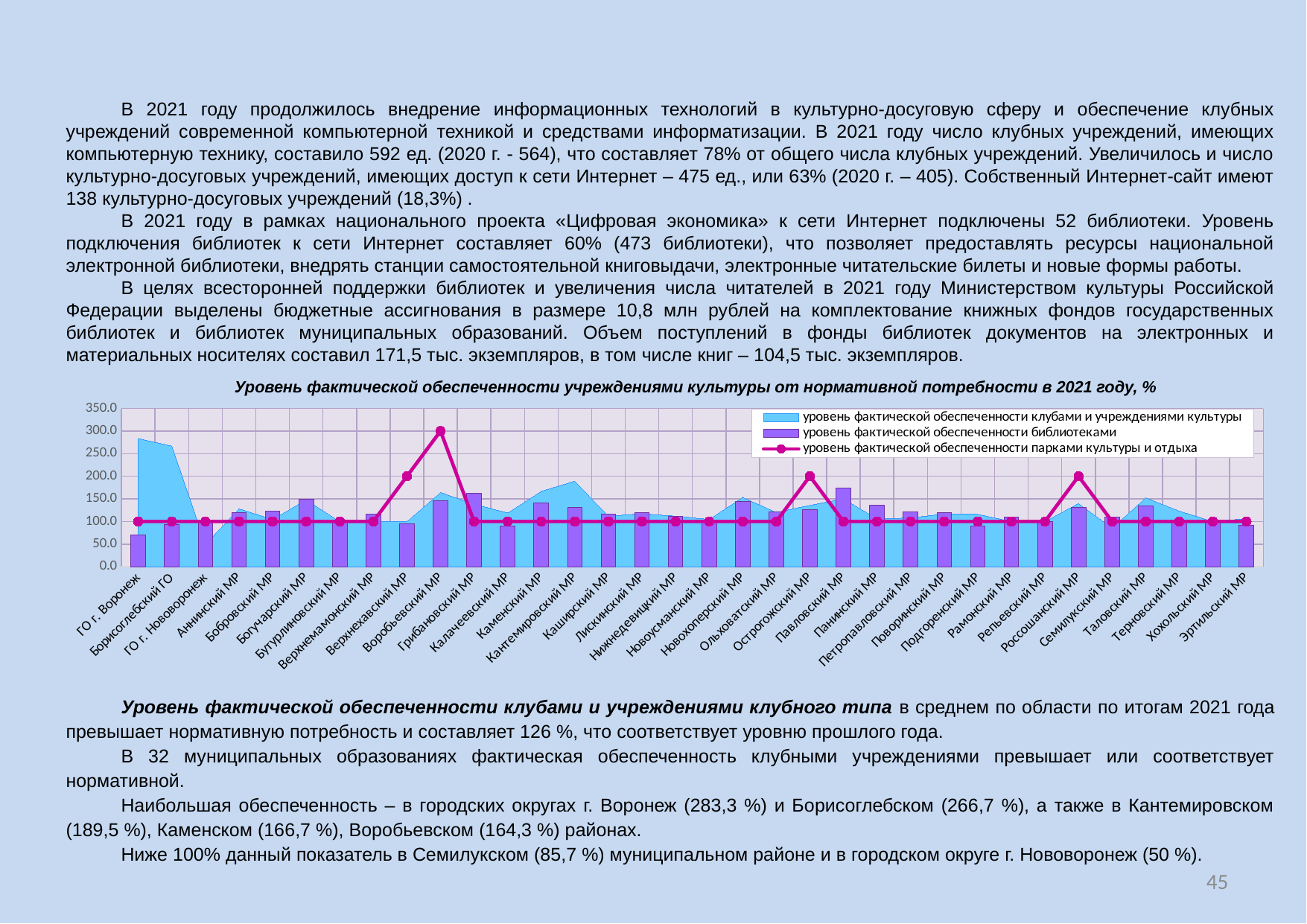
How many municipalities are shown along the x axis of the chart? 34 What is the title of the chart? Уровень фактической обеспеченности учреждениями культуры от нормативной потребности в 2021 году, % How many series does the chart legend list? 3 Is the level of provision with libraries in Павловский МР greater or less than 150? greater Is the level of provision with libraries in ГО г. Воронеж greater or less than 100? less What kind of chart is used for the series on provision with libraries? bar chart Is the level of provision with clubs in ГО г. Воронеж greater or less than 250? greater Which municipality has the lowest level of provision with clubs and cultural institutions? ГО г. Нововоронеж Which municipality has the highest level of provision with parks of culture and recreation? Воробьевский МР Which is larger: the level of provision with parks in Воробьевский МР or in Острогожский МР? Воробьевский МР Which municipality has the highest level of provision with clubs and cultural institutions? ГО г. Воронеж